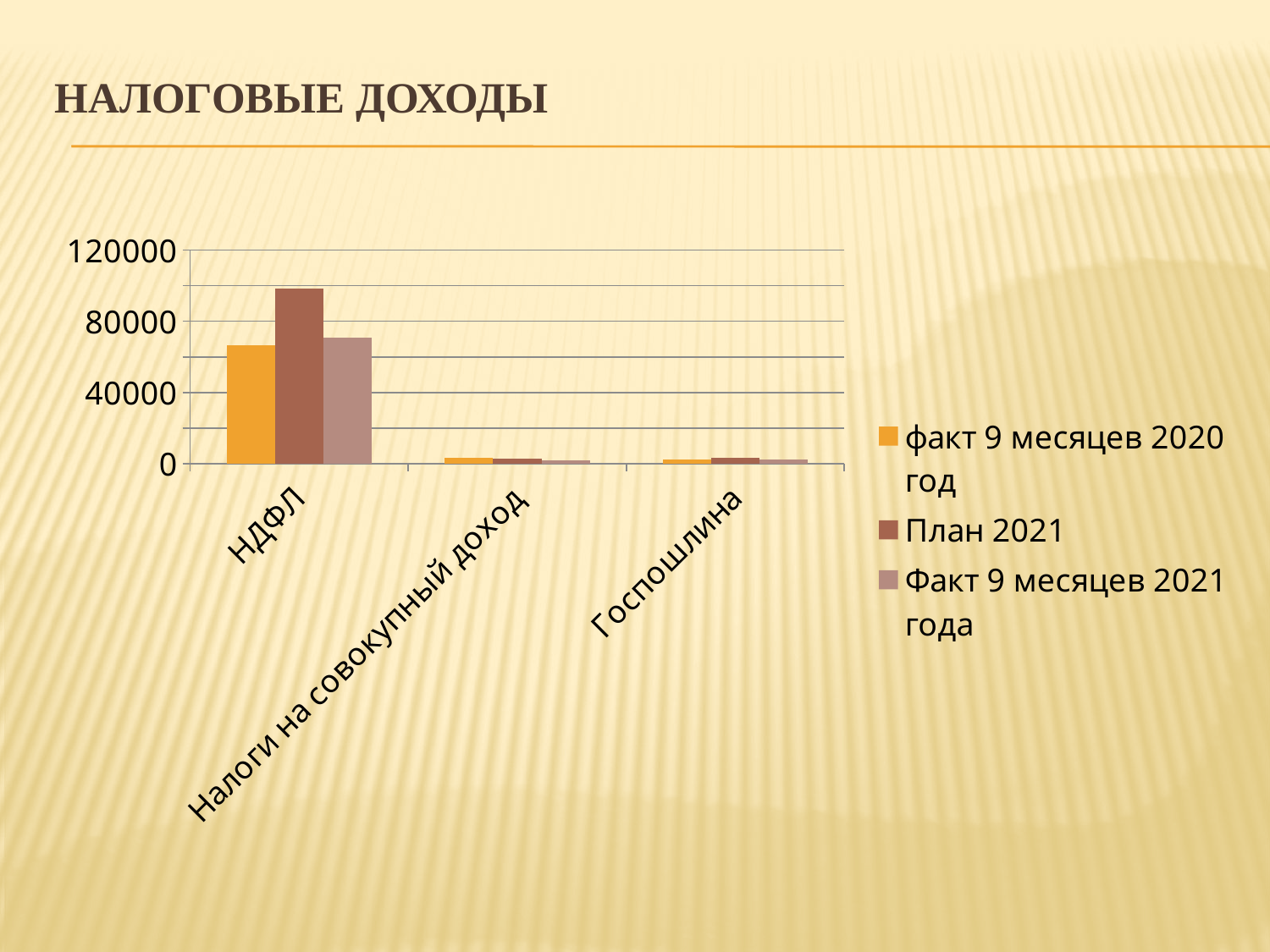
What kind of chart is shown on the slide? bar chart Is the value of План 2021 for НДФЛ greater or less than 80000? greater What is the title of the slide? НАЛОГОВЫЕ ДОХОДЫ Is the value of факт 9 месяцев 2020 год for НДФЛ greater or less than 80000? less How many categories are shown on the x axis? 3 Which category has the highest values across all series? НДФЛ Is the value of Факт 9 месяцев 2021 года for НДФЛ greater or less than 80000? less Which series is shown in the darkest brown colour in the legend? План 2021 For НДФЛ, which is larger: План 2021 or факт 9 месяцев 2020 год? План 2021 How many series does the legend list? 3